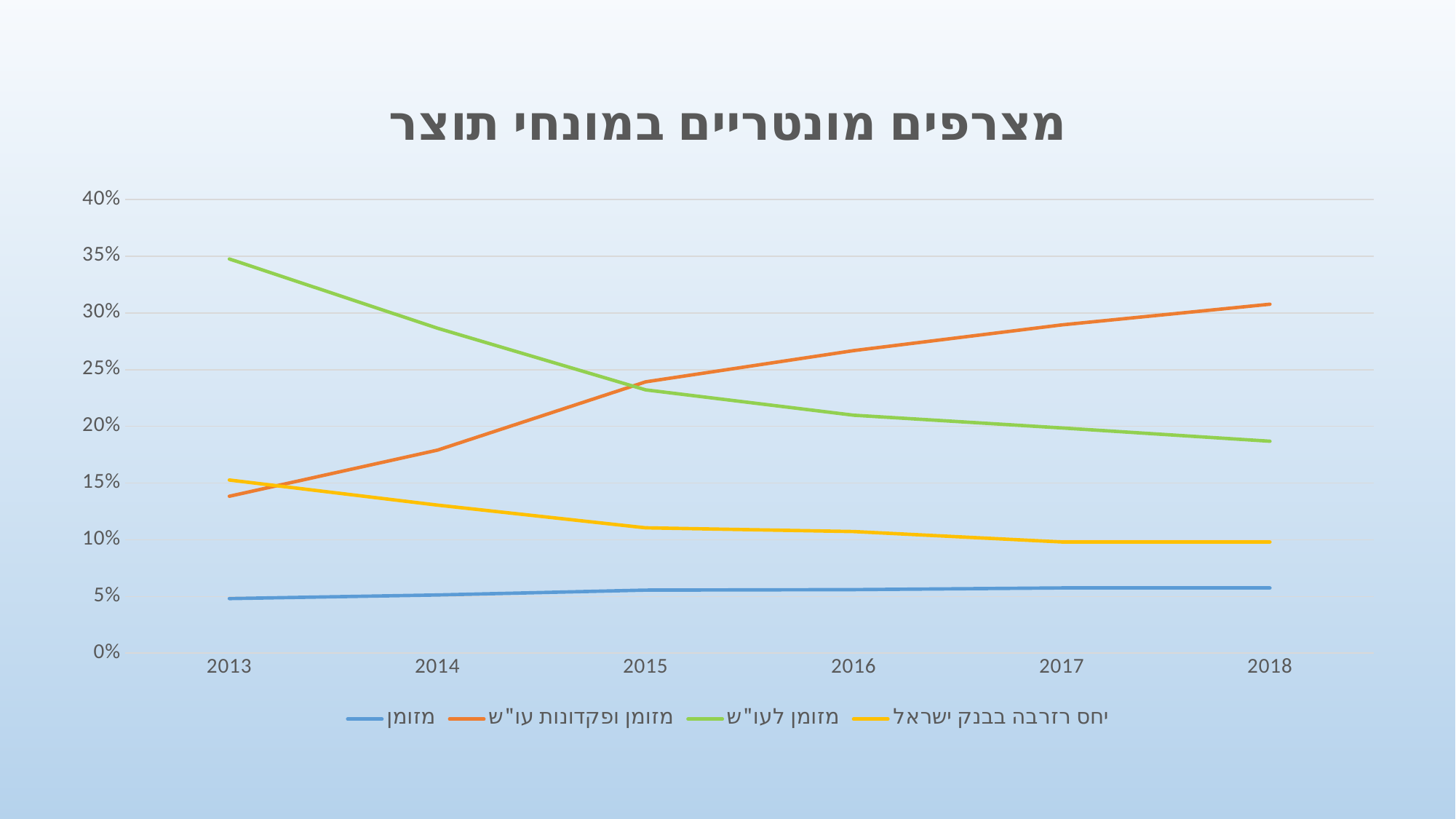
Is the value for מזומן ופקדונות עו"ש in 2018 greater or less than 30%? greater Is the value for מזומן לעו"ש in 2013 greater or less than 30%? greater Does the value for יחס רזרבה בבנק ישראל rise or fall from 2013 to 2018? fall Which series has the highest value in 2013? מזומן לעו"ש Does the value for מזומן ופקדונות עו"ש rise or fall from 2013 to 2018? rise Does the value for מזומן לעו"ש rise or fall from 2013 to 2018? fall What is the title of the chart? מצרפים מונטריים במונחי תוצר How many series does the legend list? 4 In 2018, which is larger: מזומן ופקדונות עו"ש or מזומן לעו"ש? מזומן ופקדונות עו"ש What kind of chart is shown on the slide? line chart How many years are shown on the x axis? 6